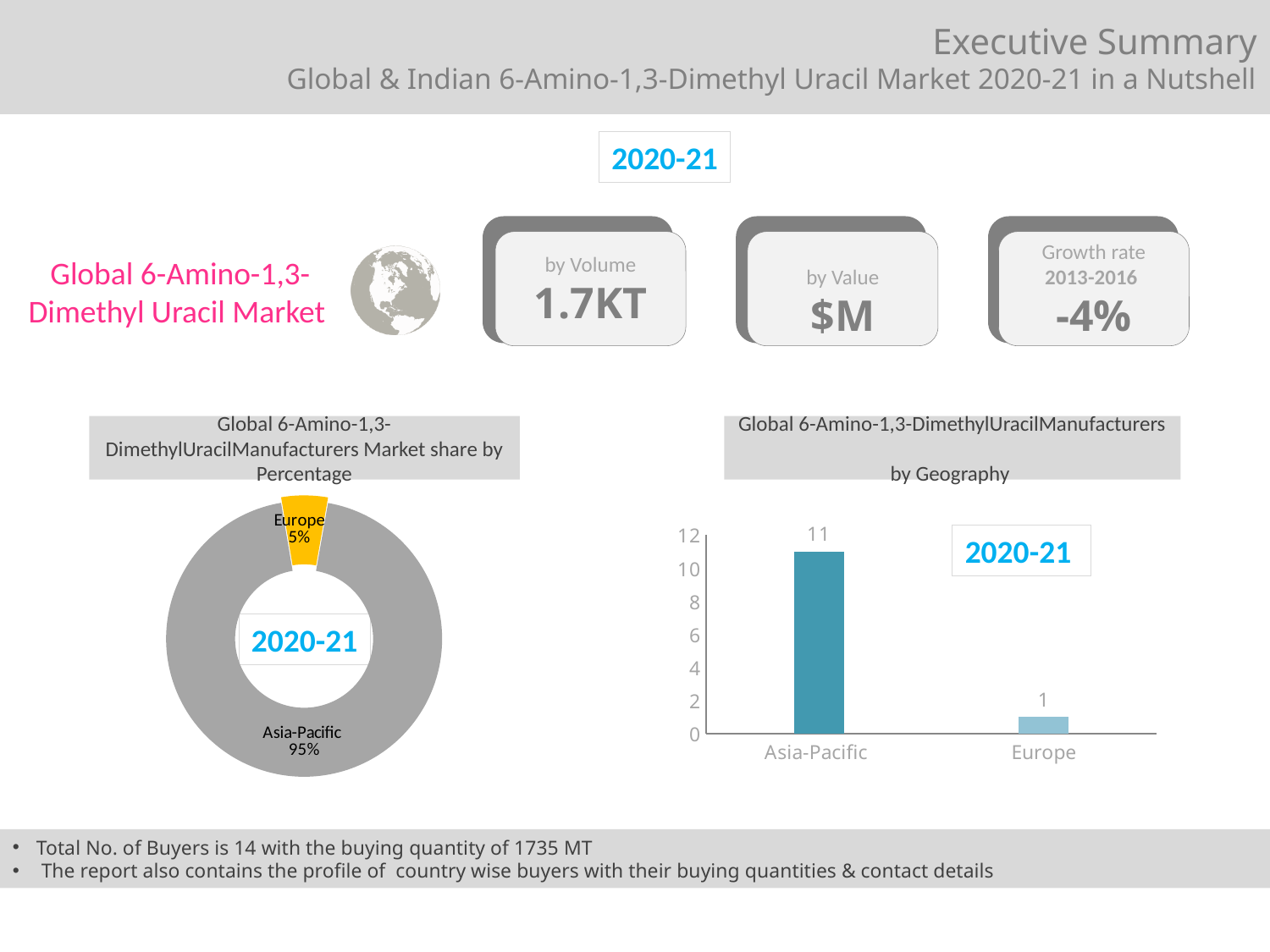
In the 'Market share by Percentage' doughnut chart, what is the share for Asia-Pacific? 95% In the 'Manufacturers by Geography' bar chart, is the value for Asia-Pacific greater or less than 10? greater What kind of chart is the 'Manufacturers by Geography' chart on the right? Bar chart In the 'Manufacturers by Geography' bar chart, which region has the lowest value? Europe In the 'Market share by Percentage' doughnut chart, what is the difference between the Asia-Pacific and Europe shares? 90% In the 'Manufacturers by Geography' bar chart, what is the difference between Asia-Pacific and Europe? 10 In the 'Manufacturers by Geography' bar chart, what is the value for Europe? 1 In the 'Market share by Percentage' doughnut chart, how many regions are shown? 2 In the 'Market share by Percentage' doughnut chart, which region has the largest share? Asia-Pacific In the 'Market share by Percentage' doughnut chart, what is the share for Europe? 5% What kind of chart is the 'Market share by Percentage' chart on the left? Doughnut chart In the 'Manufacturers by Geography' bar chart, what is the value for Asia-Pacific? 11